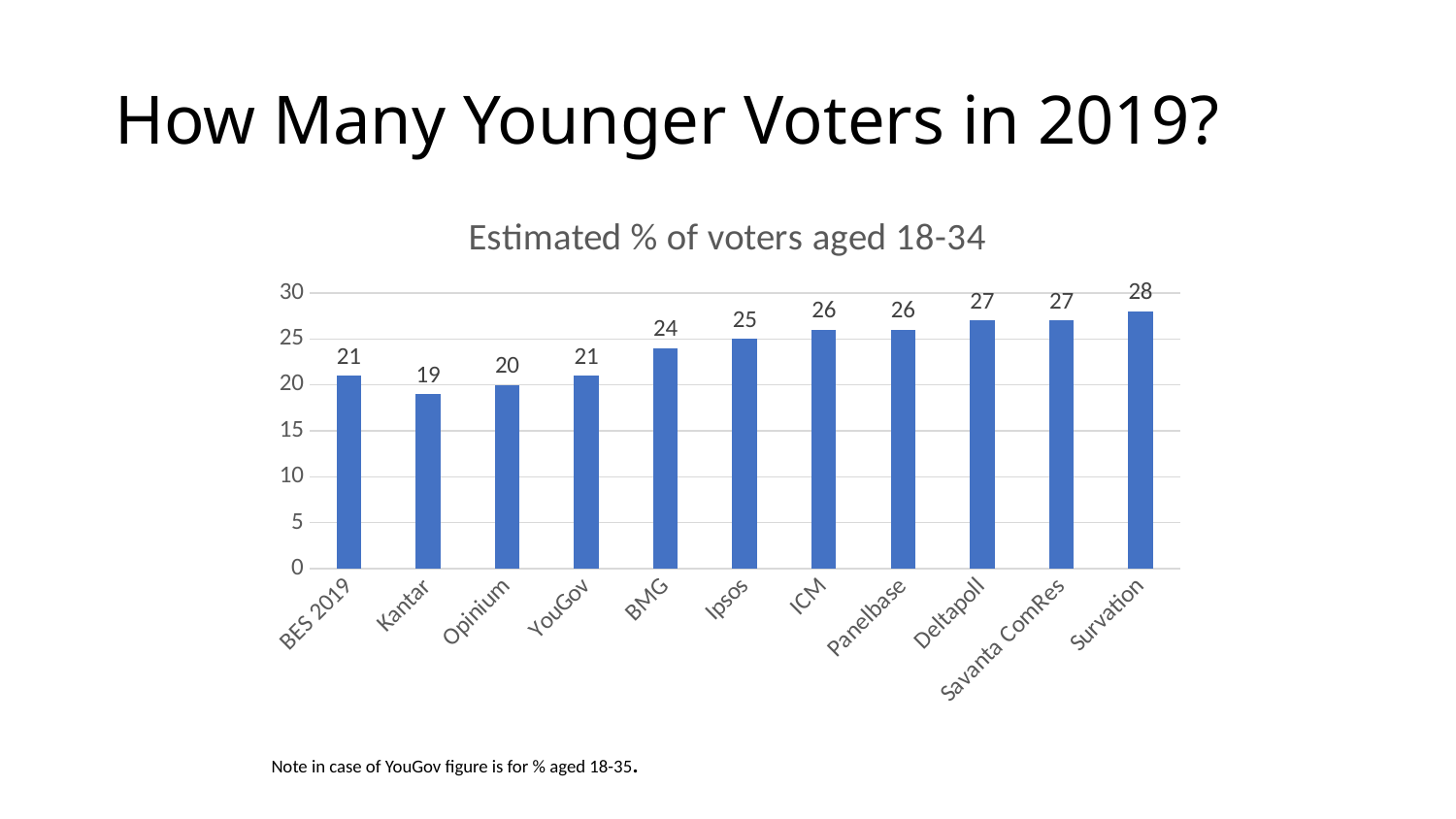
What is the estimated % of voters aged 18-34 for Deltapoll? 27 What is the estimated % of voters aged 18-34 for Kantar? 19 How many pollsters are shown on the chart? 11 Which is larger, the estimate for ICM or the estimate for YouGov? ICM What kind of chart is shown on the slide? Bar chart What is the estimated % of voters aged 18-34 for Ipsos? 25 Which pollster has the highest estimated % of voters aged 18-34? Survation Which pollster has the lowest estimated % of voters aged 18-34? Kantar What is the title of the chart? Estimated % of voters aged 18-34 What is the difference between the Survation and Kantar estimates? 9 What is the difference between the BMG and Opinium estimates? 4 Is the value for Panelbase greater or less than 25? greater